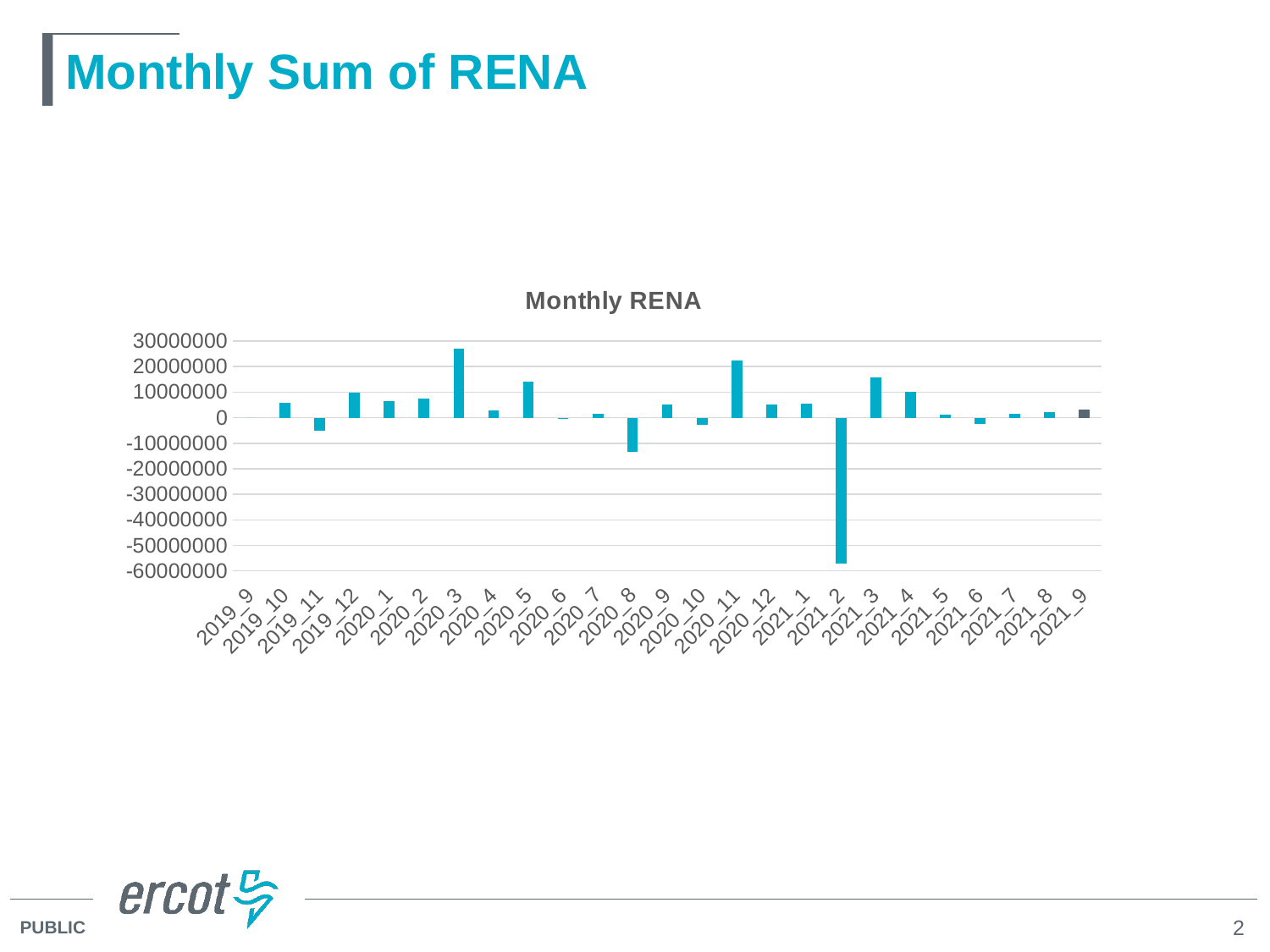
Is the value for 2020_8 greater or less than -10000000? less Is the value for 2020_3 greater or less than 20000000? greater Which month has the highest Monthly RENA value? 2020_3 Which is larger, the value for 2020_5 or the value for 2020_4? 2020_5 Which is larger, the value for 2020_3 or the value for 2020_11? 2020_3 Which month has the lowest Monthly RENA value? 2021_2 How many months (categories) are plotted on the x axis? 25 What type of chart is shown on the slide? bar chart What is the title of the chart? Monthly RENA Is the value for 2021_2 greater or less than -50000000? less